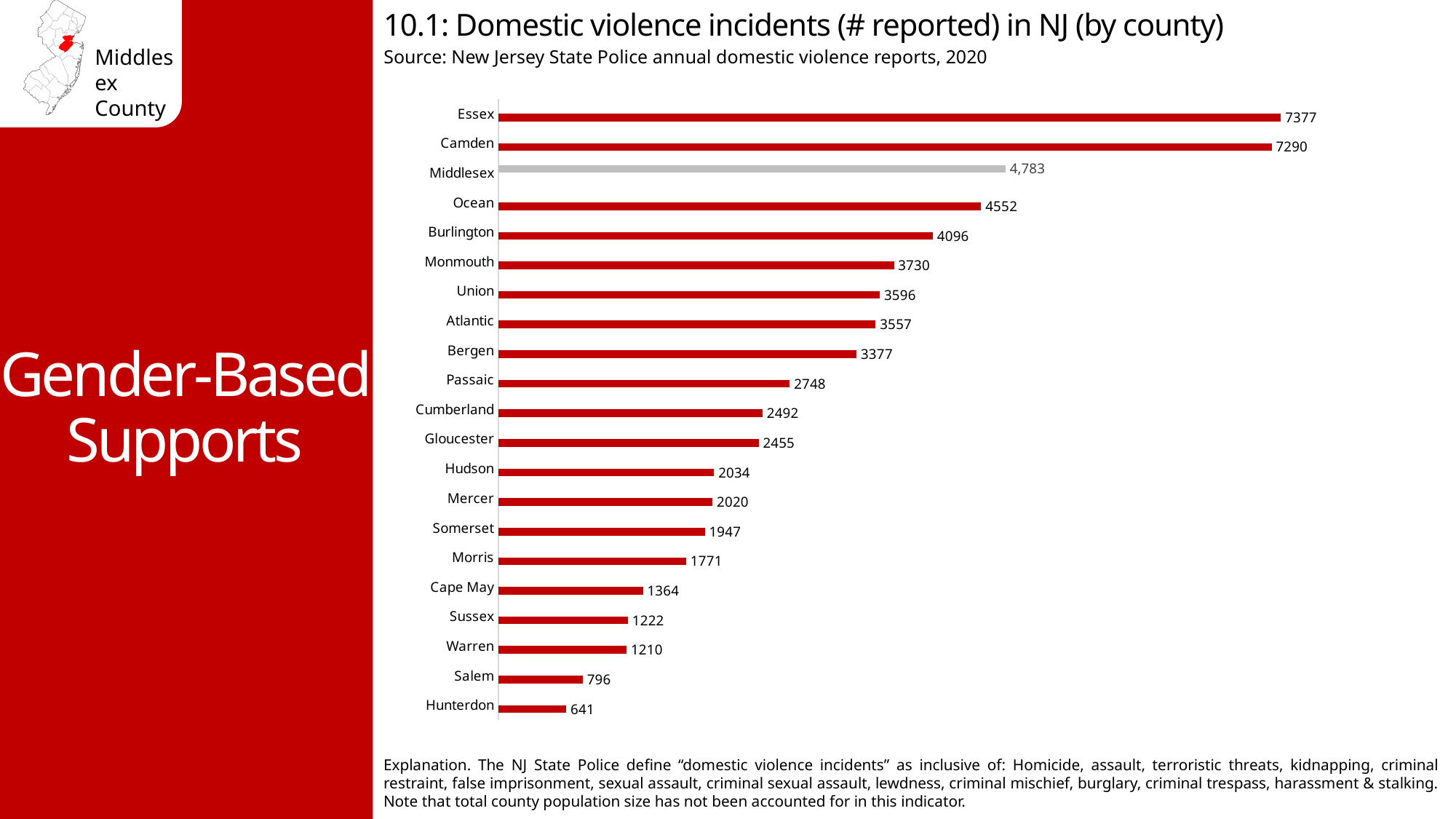
How many counties are shown in the chart? 21 Which county has the highest number of reported domestic violence incidents? Essex What type of chart is used to show domestic violence incidents by county? Bar chart What is the difference between the number of incidents in Middlesex and Ocean? 231 Which county's bar is shown in grey instead of red? Middlesex Which county has the lowest number of reported domestic violence incidents? Hunterdon What is the difference between the number of incidents in Essex and Camden? 87 What is the number of reported domestic violence incidents for Hudson County? 2034 What is the number of reported domestic violence incidents for Ocean County? 4552 What is the number of reported domestic violence incidents for Middlesex County? 4,783 Which county has more reported incidents, Bergen or Passaic? Bergen Which county has more reported incidents, Salem or Warren? Warren